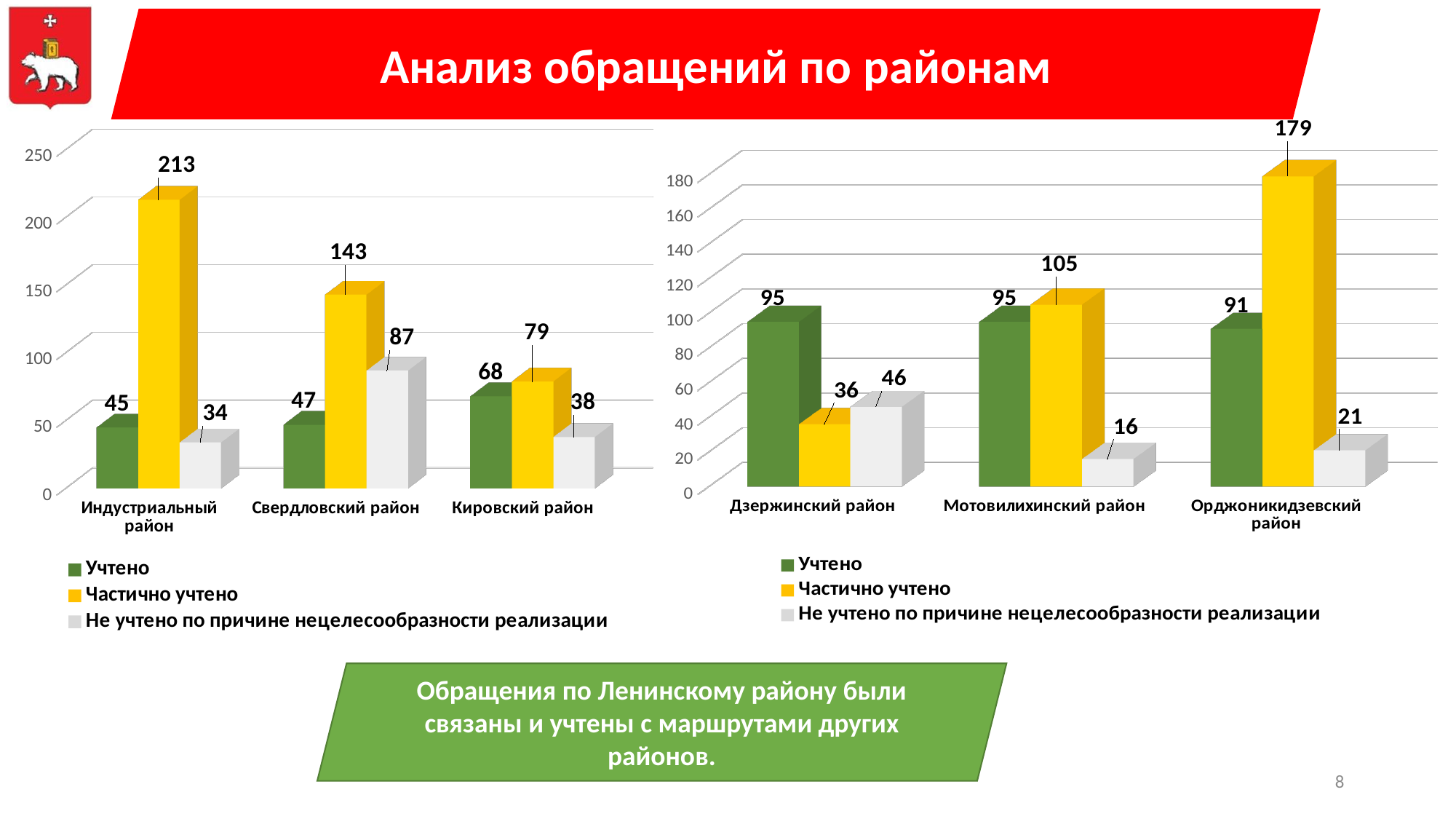
In the right chart, which district has the highest value of "Частично учтено"? Орджоникидзевский район In the right chart, which is larger for Дзержинский район: "Учтено" or "Не учтено по причине нецелесообразности реализации"? Учтено In the left chart, what is the difference between "Частично учтено" and "Учтено" for Свердловский район? 96 In the left chart, what is the total of the three values for Кировский район? 185 In the left chart, what is the value of "Частично учтено" for Индустриальный район? 213 In the right chart, what is the value of "Не учтено по причине нецелесообразности реализации" for Мотовилихинский район? 16 How many series does the legend of the right chart list? 3 In the left chart, which district has the lowest value of "Не учтено по причине нецелесообразности реализации"? Индустриальный район What type of chart is the left chart? Bar chart How many districts are shown in the left chart? 3 In the left chart, what is the value of "Учтено" for Кировский район? 68 In the right chart, what is the difference between "Частично учтено" for Орджоникидзевский район and for Дзержинский район? 143